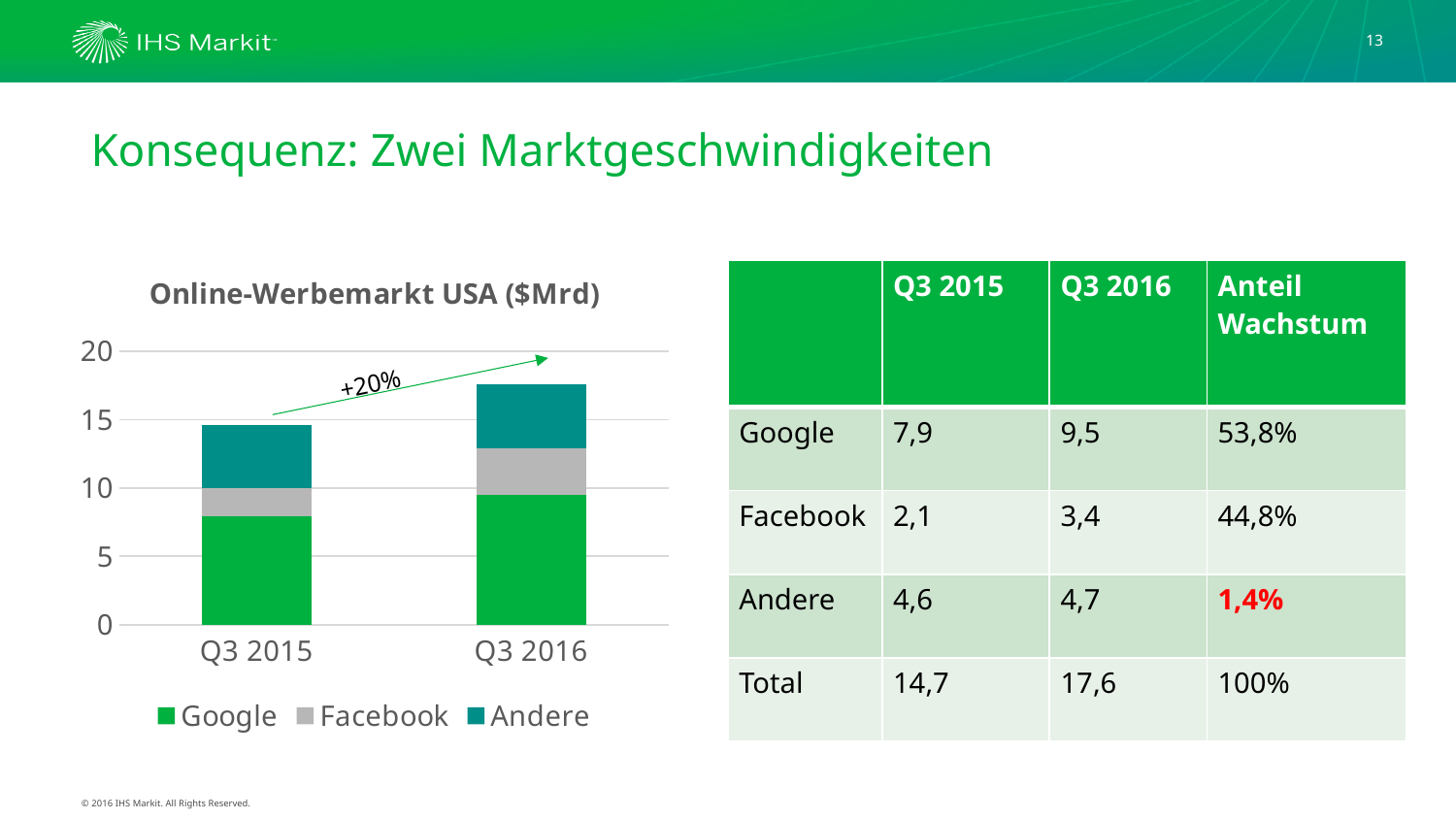
Which bar is taller, Q3 2015 or Q3 2016? Q3 2016 Do the total values rise or fall from Q3 2015 to Q3 2016? rise What kind of chart is shown on the slide? Stacked bar chart According to the table on the slide, what is the total value of the Q3 2016 stacked bar? 17,6 How many series does the chart legend list? 3 Which series has the largest segment in the Q3 2016 bar? Google According to the table on the slide, what is the difference between Google's Q3 2016 and Q3 2015 values? 1,6 What is the title of the chart? Online-Werbemarkt USA ($Mrd) Is the Google segment of the Q3 2015 bar greater or less than 10? less How many categories are shown on the x axis of the chart? 2 Which series are listed in the chart legend? Google, Facebook, Andere Is the total height of the Q3 2016 bar greater or less than 15? greater